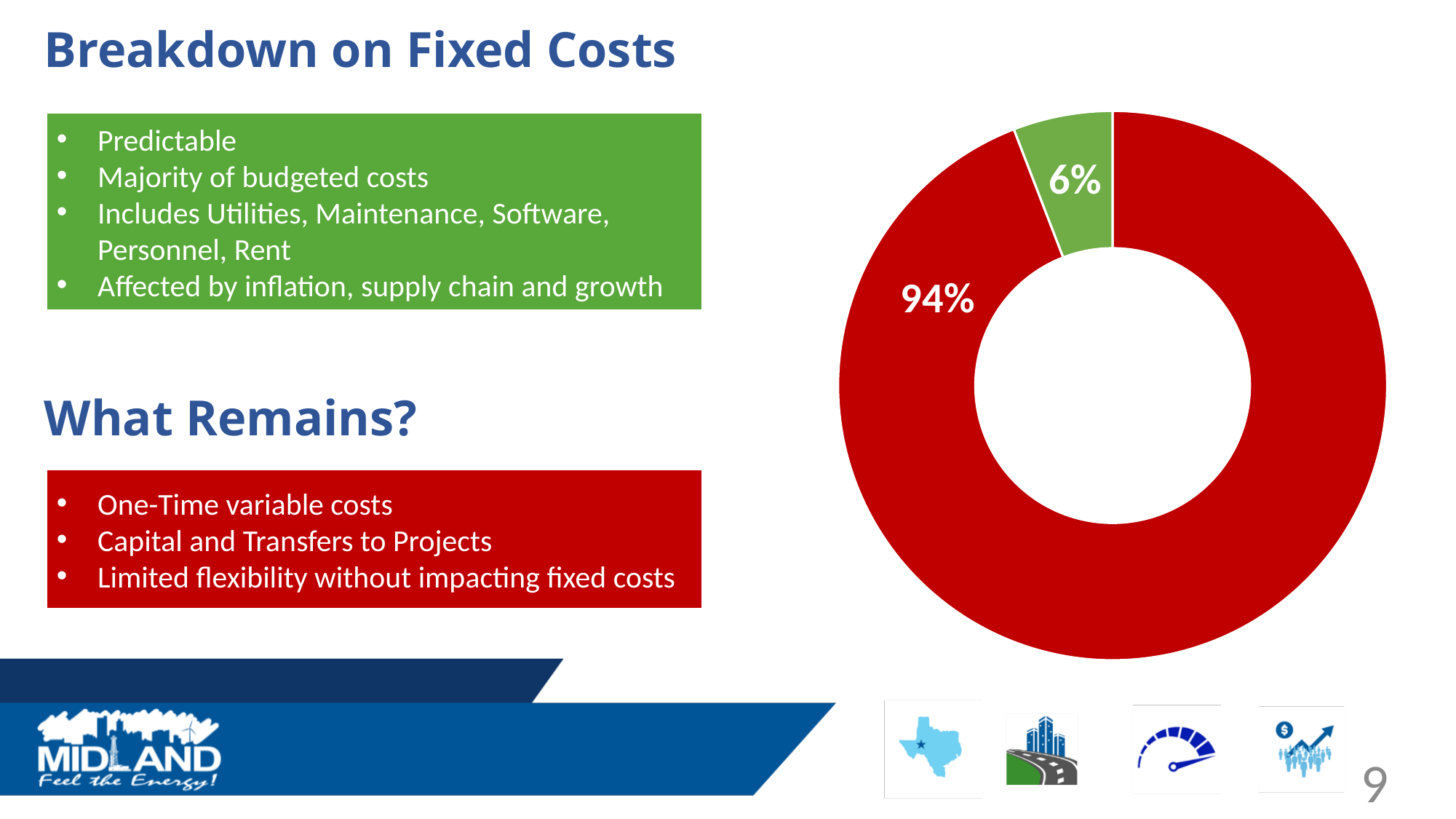
What is the title of the slide containing the donut chart? Breakdown on Fixed Costs How many slices does the donut chart have? 2 Is the red slice's share of the donut chart greater or less than 50%? greater Which is larger in the donut chart, the red slice or the green slice? The red slice Which slice of the donut chart is the smallest? The green slice (6%) What percentage is shown on the red slice of the donut chart? 94% Which slice of the donut chart is the largest? The red slice (94%) What percentage is shown on the green slice of the donut chart? 6% What is the difference in percentage points between the red slice and the green slice? 88 percentage points What do the two slice percentages in the donut chart add up to? 100% What kind of chart is shown on the slide? Pie chart (donut) What colours are used for the two slices of the donut chart? Red and green